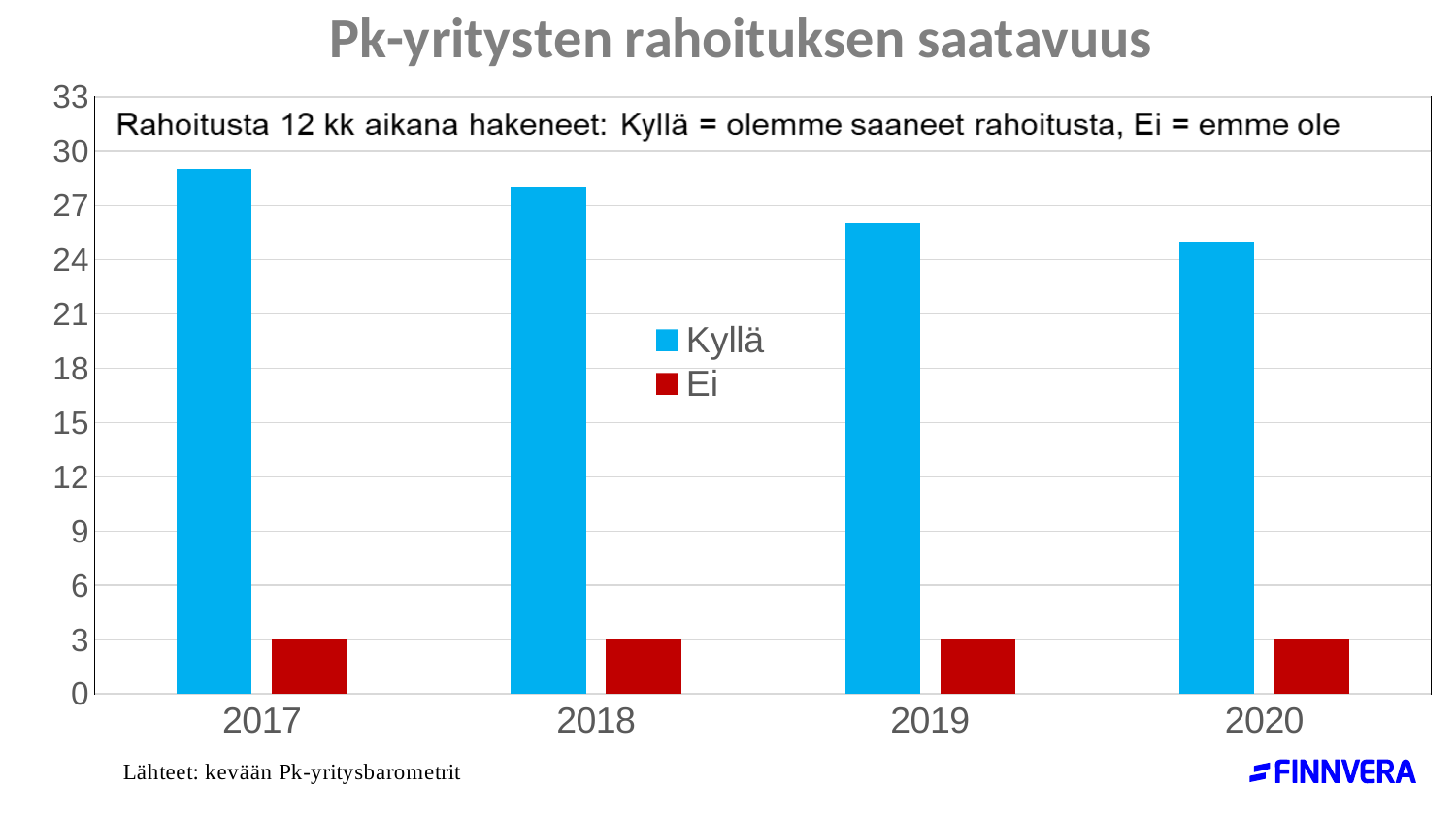
How many series does the legend list? 2 In which year is the Kyllä value lowest? 2020 Is the Kyllä value for 2020 greater or less than 27? less Do the Kyllä values rise or fall from 2017 to 2020? fall In which year is the Kyllä value highest? 2017 How many years are shown on the x axis? 4 Which is larger, the Kyllä value for 2018 or the Kyllä value for 2019? 2018 Is the Kyllä value for 2017 greater or less than 27? greater What is the value of the Ei series for 2020? 3 What kind of chart is shown on the slide? bar chart What colour are the Kyllä bars? blue What is the value of the Ei series for 2017? 3